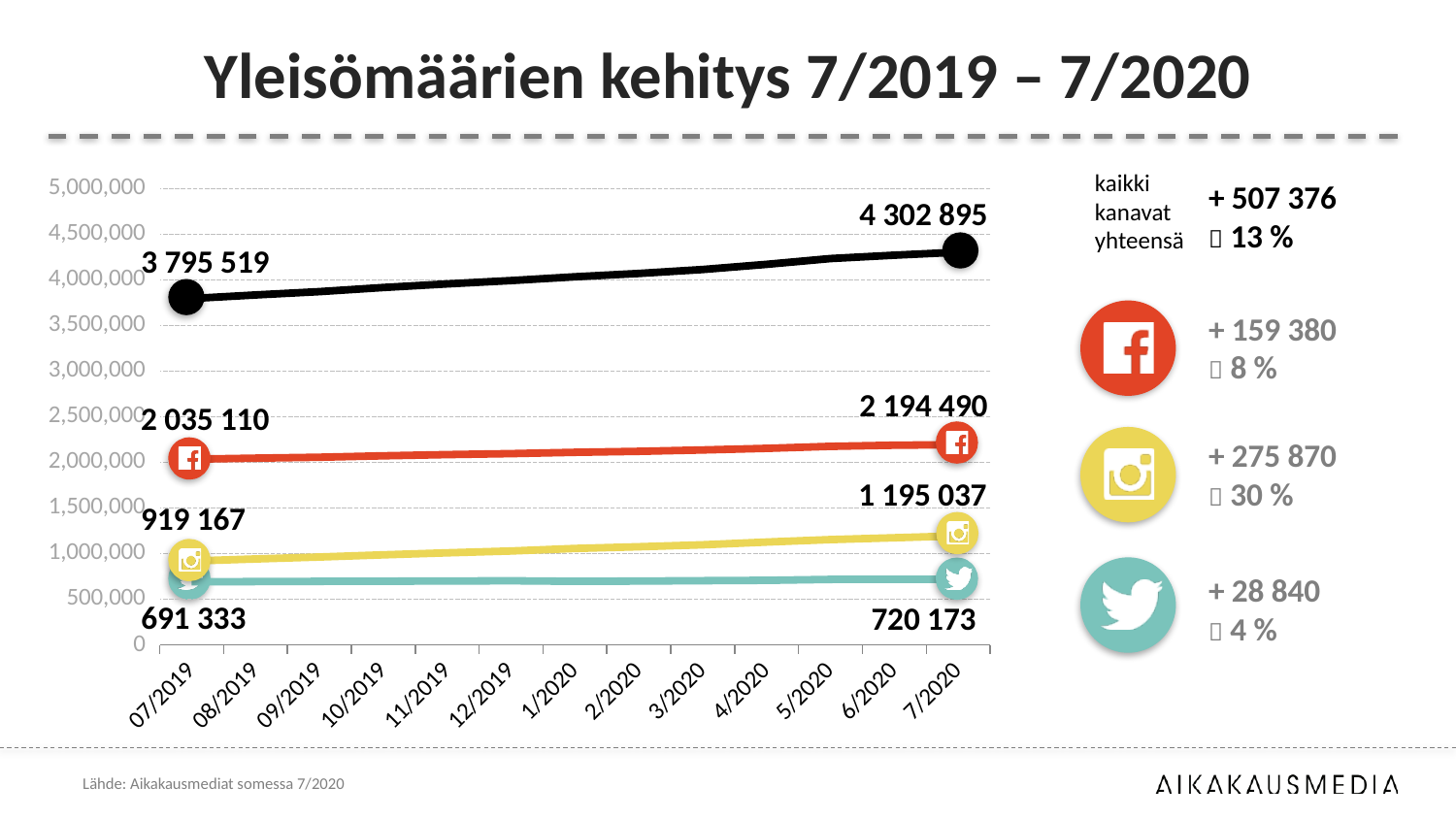
What is the value of the Facebook line at 7/2020? 2 194 490 Does the Instagram line rise or fall from 07/2019 to 7/2020? rise What is the title of the chart? Yleisömäärien kehitys 7/2019 – 7/2020 What is the value of the Twitter line at 7/2020? 720 173 By how much did the black (total) line increase from 07/2019 to 7/2020? 507 376 What is the value of the black (total) line at 07/2019? 3 795 519 What type of chart is shown on the slide? line chart Which line has the lowest value at 7/2020? Twitter How many months are shown on the x axis? 13 What is the value of the black (total) line at 7/2020? 4 302 895 Which is larger at 7/2020, the Facebook value or the Instagram value? Facebook What is the value of the Instagram line at 07/2019? 919 167